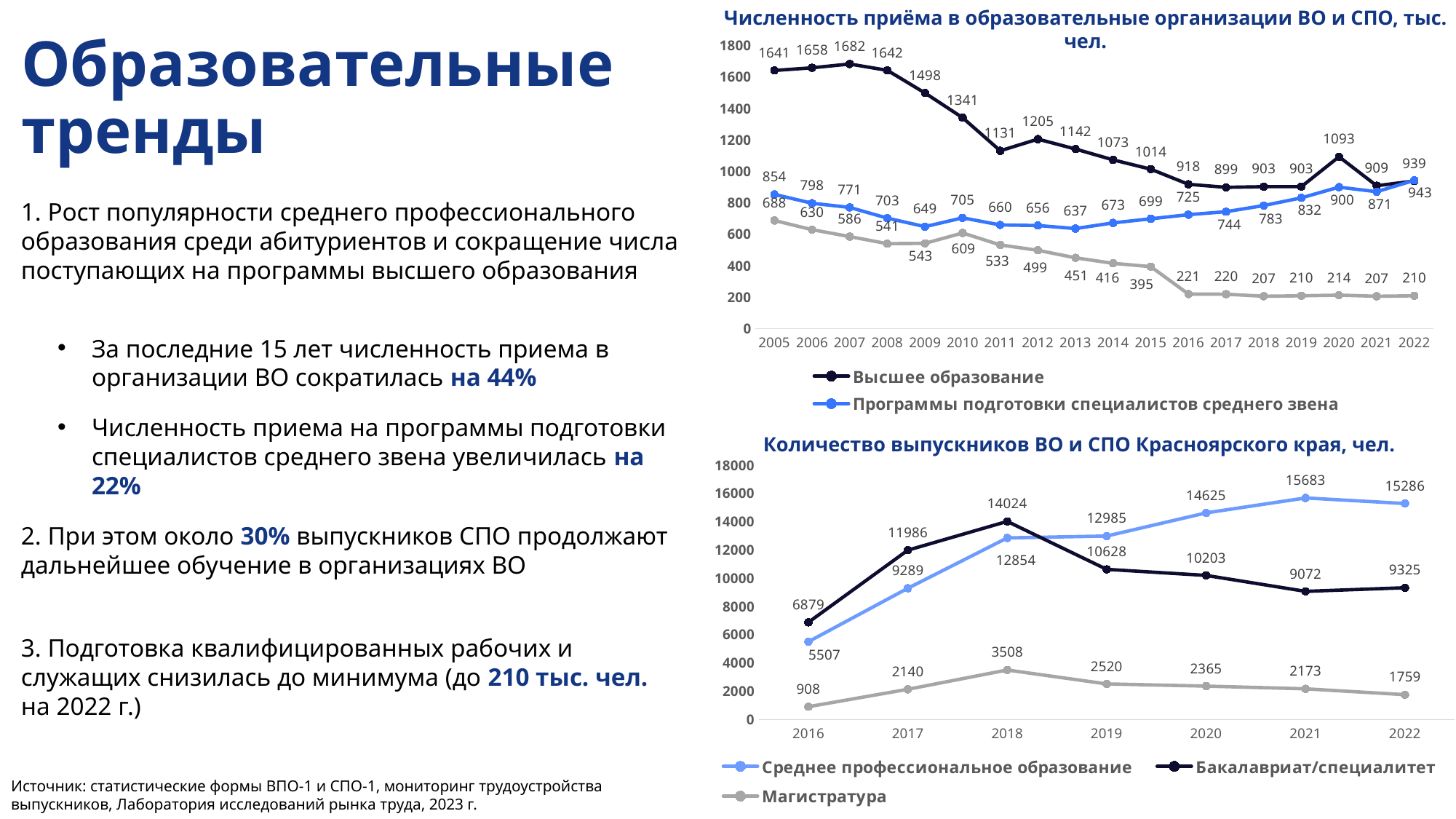
In the top chart 'Численность приёма в образовательные организации ВО и СПО', how many years are shown on the x axis? 18 In the top chart 'Численность приёма в образовательные организации ВО и СПО', what is the value for Высшее образование in 2007? 1682 In the top chart 'Численность приёма в образовательные организации ВО и СПО', in which year is the Высшее образование value highest? 2007 In the bottom chart 'Количество выпускников ВО и СПО Красноярского края', which is larger in 2019: Среднее профессиональное образование or Бакалавриат/специалитет? Среднее профессиональное образование In the top chart 'Численность приёма в образовательные организации ВО и СПО', how many series does the legend list? 2 In the bottom chart 'Количество выпускников ВО и СПО Красноярского края', what is the difference between the Бакалавриат/специалитет values in 2018 and 2022? 4699 In the bottom chart 'Количество выпускников ВО и СПО Красноярского края', in which year is the Среднее профессиональное образование value highest? 2021 What kind of chart is the bottom chart 'Количество выпускников ВО и СПО Красноярского края'? Line chart In the bottom chart 'Количество выпускников ВО и СПО Красноярского края', what is the value for Магистратура in 2018? 3508 In the bottom chart 'Количество выпускников ВО и СПО Красноярского края', does the Магистратура value rise or fall from 2018 to 2022? Fall In the top chart 'Численность приёма в образовательные организации ВО и СПО', what is the value for Программы подготовки специалистов среднего звена in 2022? 943 In the top chart 'Численность приёма в образовательные организации ВО и СПО', by how much did the Высшее образование value fall from 2005 to 2022? 702